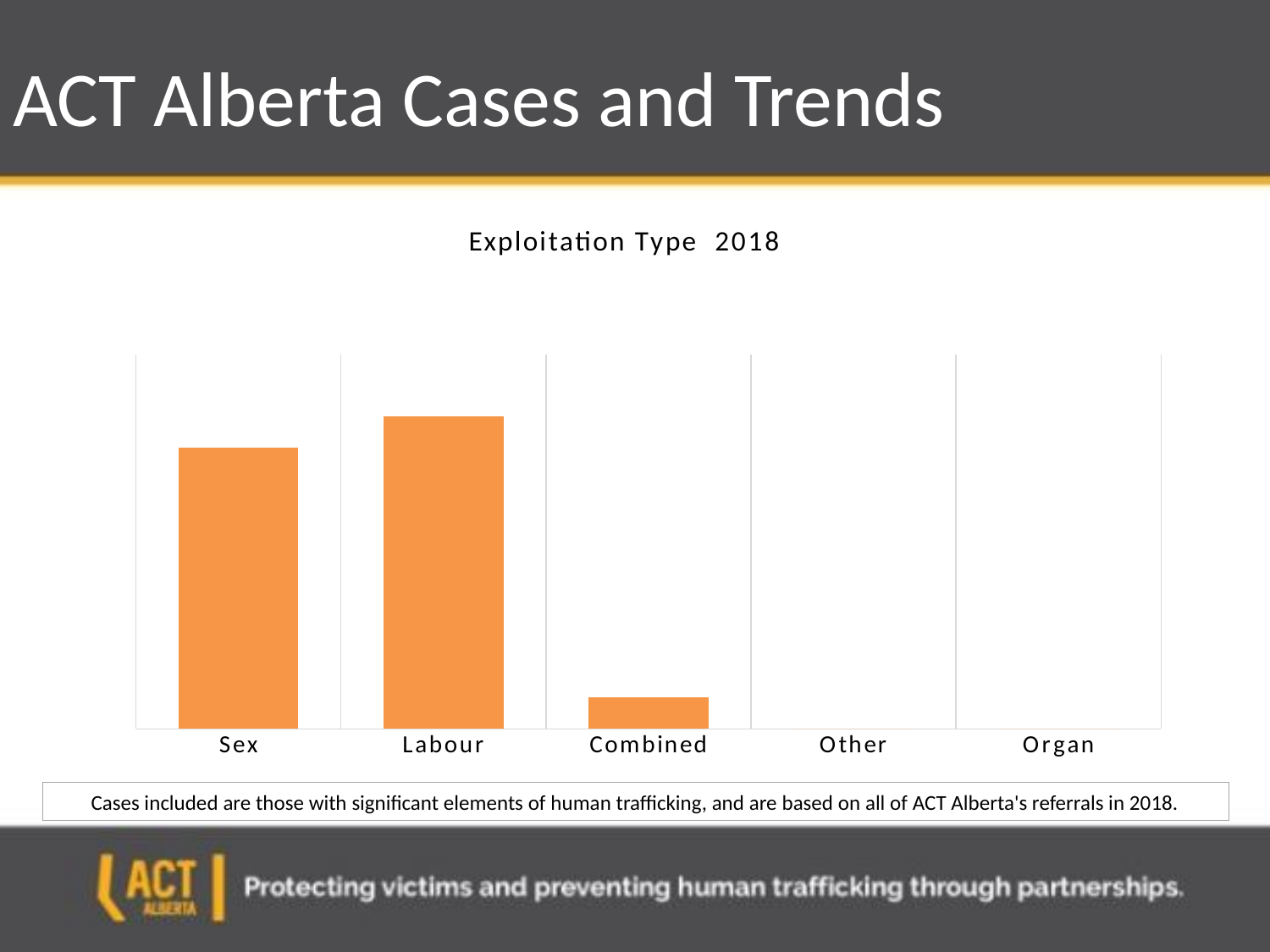
Which is larger, the value for Sex or the value for Labour? Labour Which is larger, the value for Sex or the value for Combined? Sex Do the bar heights rise or fall from Labour to Organ along the x axis? fall Which exploitation type has the tallest bar in the chart? Labour How many categories are shown on the x axis of the chart? 5 What is the title of the chart? Exploitation Type 2018 Which is larger, the value for Labour or the value for Combined? Labour What type of chart is shown on the slide? bar chart Which of the categories with a visible bar has the shortest bar? Combined Which categories on the chart show no visible bar? Other and Organ